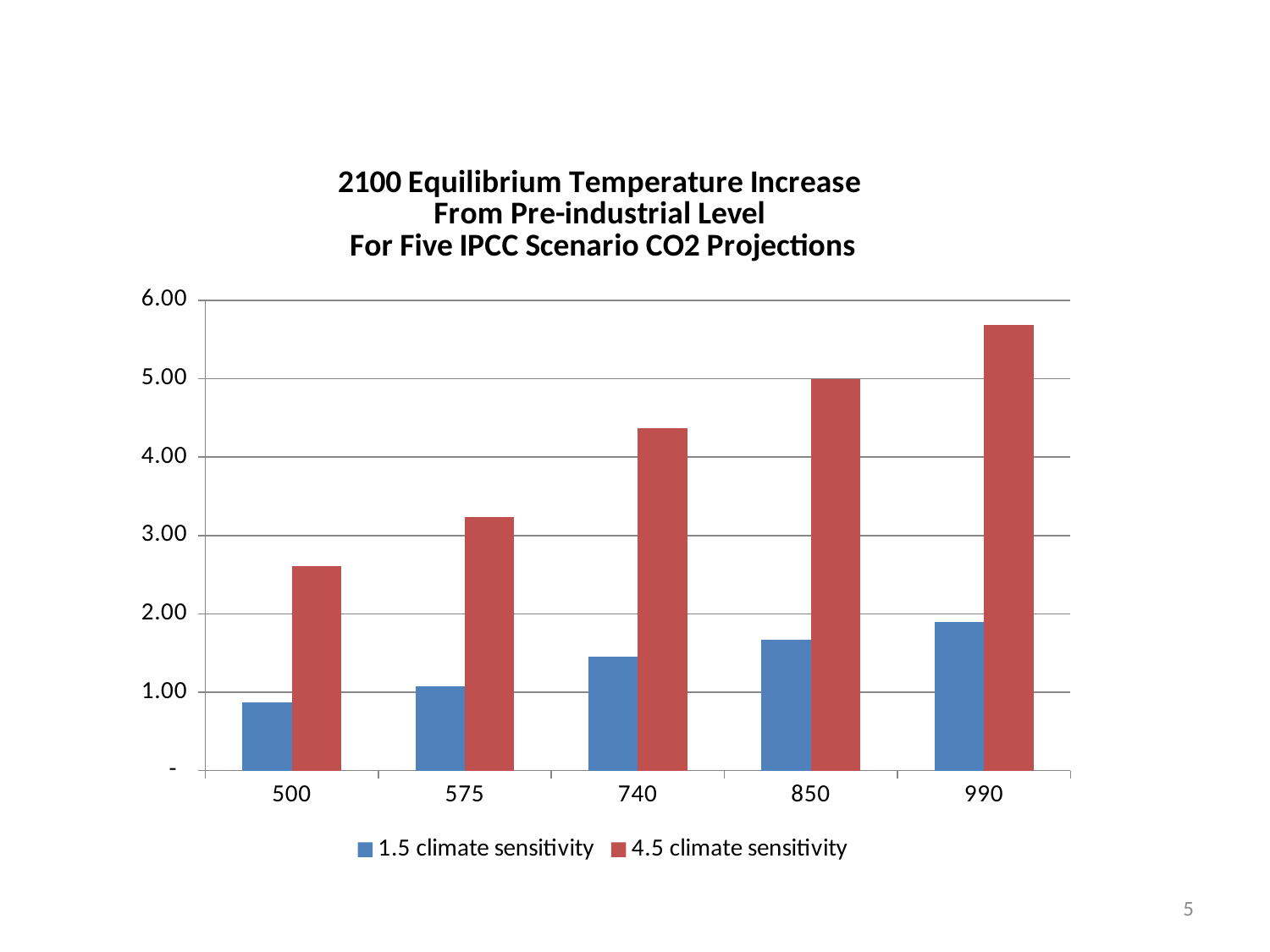
Which is larger at 575: the 1.5 climate sensitivity value or the 4.5 climate sensitivity value? 4.5 climate sensitivity What colour are the bars for the 4.5 climate sensitivity series? red How many CO2 projection categories are shown on the x axis? 5 Which category has the highest value for the 4.5 climate sensitivity series? 990 Which category has the lowest value for the 1.5 climate sensitivity series? 500 Is the value for 4.5 climate sensitivity at 990 greater or less than 5.00? greater Do the values for the 4.5 climate sensitivity series rise or fall as you move from 500 to 990 along the x axis? rise Is the value for 1.5 climate sensitivity at 500 greater or less than 1.00? less What kind of chart is shown on the slide? bar chart Is the value for 4.5 climate sensitivity at 740 greater or less than 4.00? greater How many series does the legend list? 2